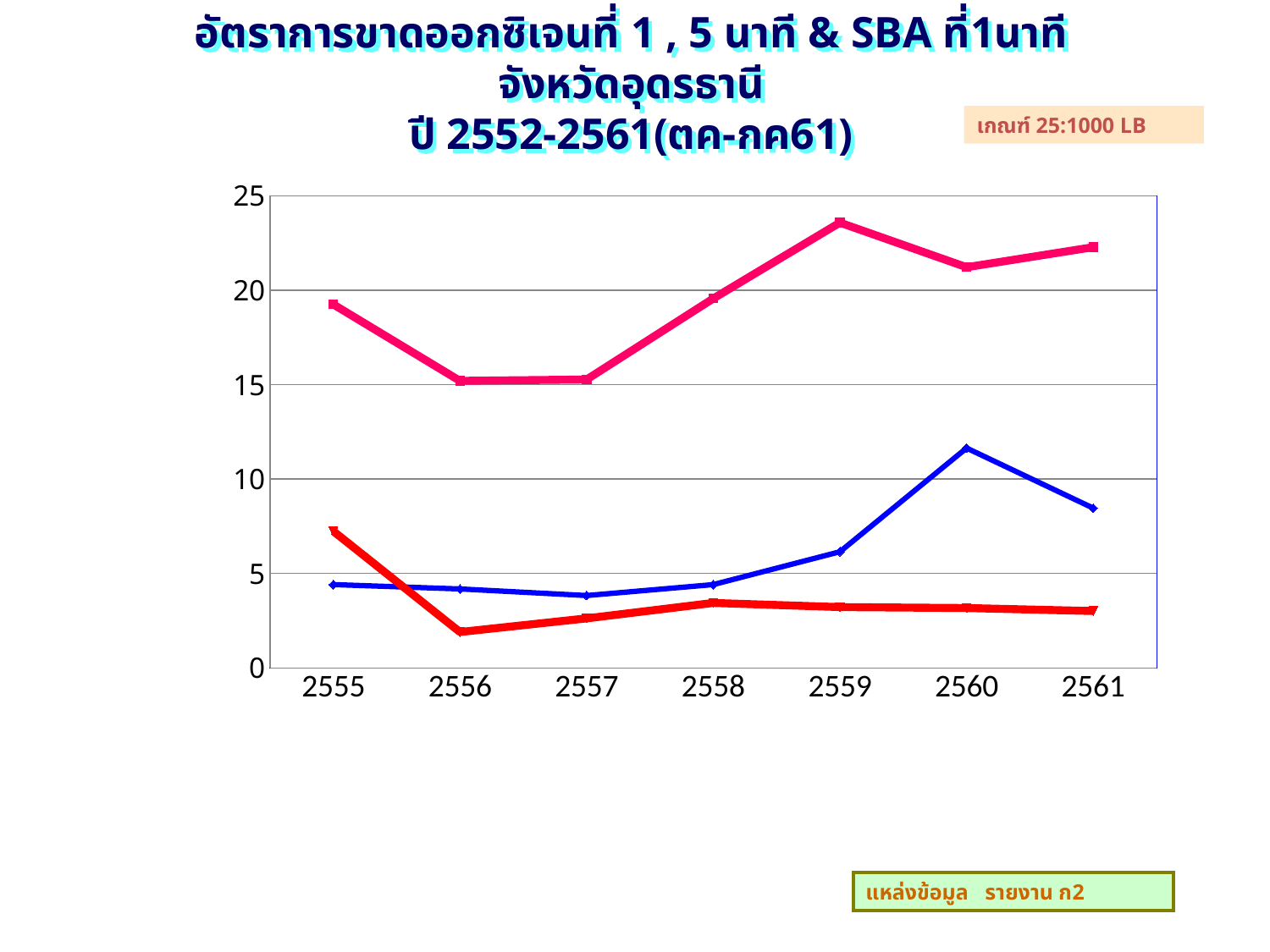
In which year does the red line reach its lowest value? 2556 Is the value of the red line in 2555 greater or less than 5? greater In which year does the pink line reach its highest value? 2559 How many years are shown on the x axis of the chart? 7 Is the value of the blue line in 2560 greater or less than 10? greater In 2556, which line has the larger value, the blue line or the red line? blue line In which year does the red line reach its highest value? 2555 In which year does the blue line reach its highest value? 2560 What kind of chart is shown on the slide? line chart Does the blue line rise or fall from 2559 to 2560? rise What threshold (เกณฑ์) is stated in the box at the top right of the slide? 25:1000 LB Is the value of the pink line in 2559 greater or less than 20? greater